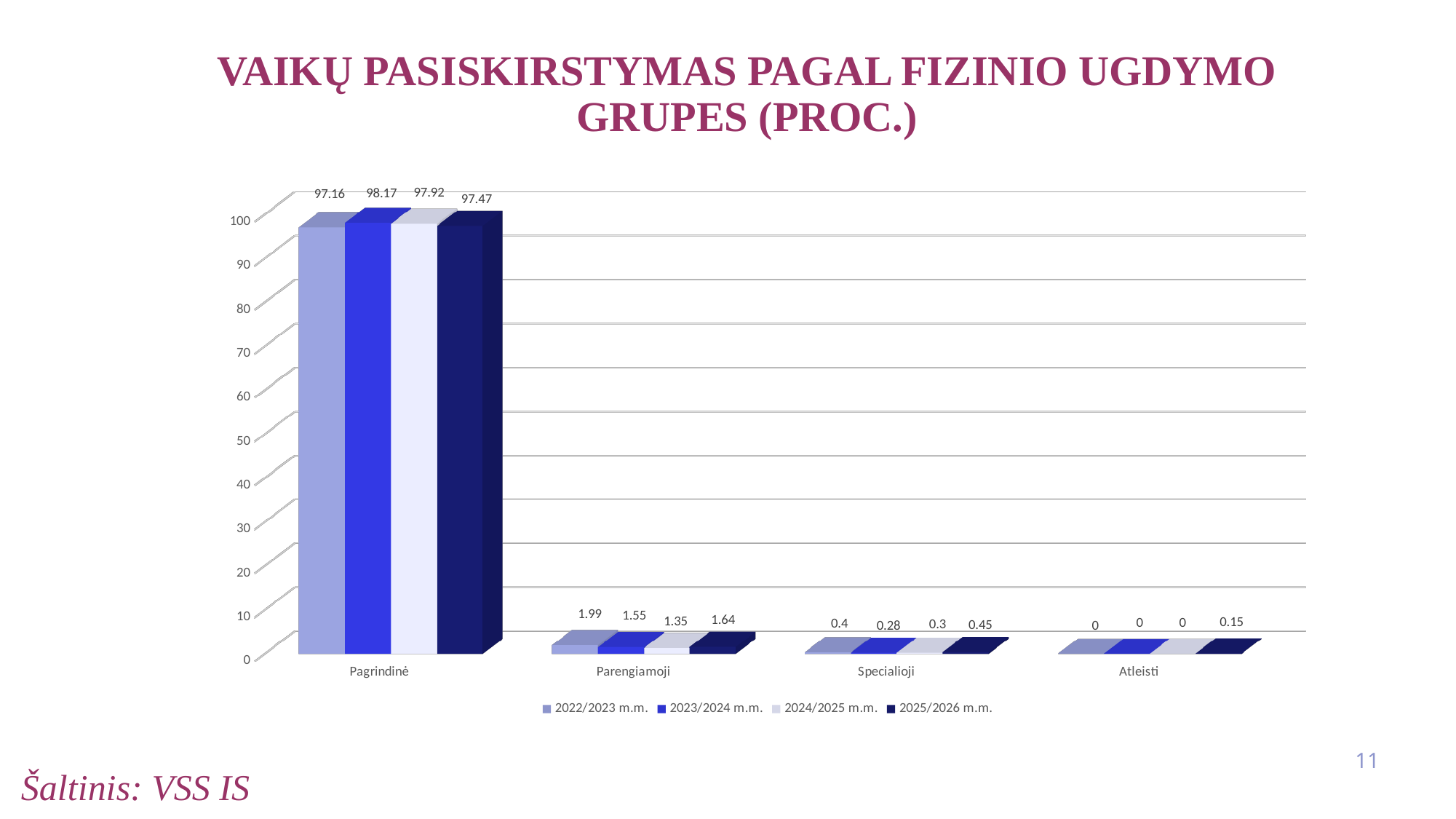
What is the value for Specialioji in 2025/2026 m.m.? 0.45 What is the title of the chart on the slide? VAIKŲ PASISKIRSTYMAS PAGAL FIZINIO UGDYMO GRUPES (PROC.) What kind of chart is shown on the slide? Bar chart Which category has the highest value in 2024/2025 m.m.? Pagrindinė What is the difference between the Pagrindinė values for 2023/2024 m.m. and 2022/2023 m.m.? 1.01 Which is larger for Parengiamoji: the 2022/2023 m.m. value or the 2024/2025 m.m. value? 2022/2023 m.m. How many series does the legend list? 4 What is the value for Atleisti in 2025/2026 m.m.? 0.15 How many categories are shown on the x axis? 4 Which category has the lowest value in 2022/2023 m.m.? Atleisti What is the value for Pagrindinė in 2023/2024 m.m.? 98.17 What is the value for Parengiamoji in 2022/2023 m.m.? 1.99